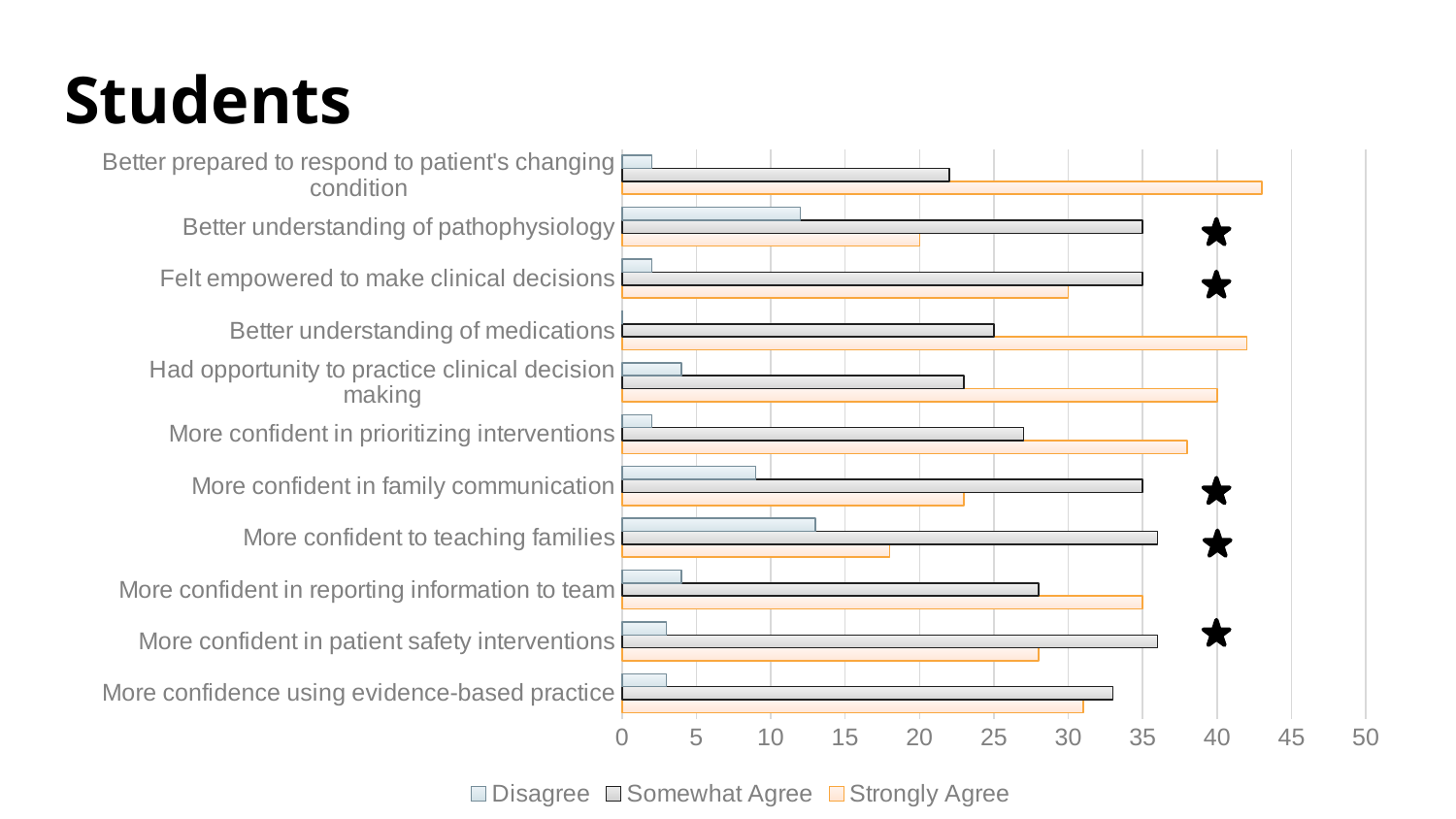
How many series does the legend list? 3 What are the three legend entries of the chart? Disagree, Somewhat Agree, Strongly Agree Is the Strongly Agree value for 'Better understanding of pathophysiology' greater or less than 25? less Is the Strongly Agree value for 'Better prepared to respond to patient's changing condition' greater or less than 40? greater For 'Better understanding of medications', which is larger: Somewhat Agree or Strongly Agree? Strongly Agree Is the Disagree value for 'More confident to teaching families' greater or less than 10? greater How many categories are plotted on the chart? 11 What is the title of the slide containing the chart? Students For 'Better understanding of pathophysiology', which is larger: Somewhat Agree or Strongly Agree? Somewhat Agree What kind of chart is shown on the slide? bar chart